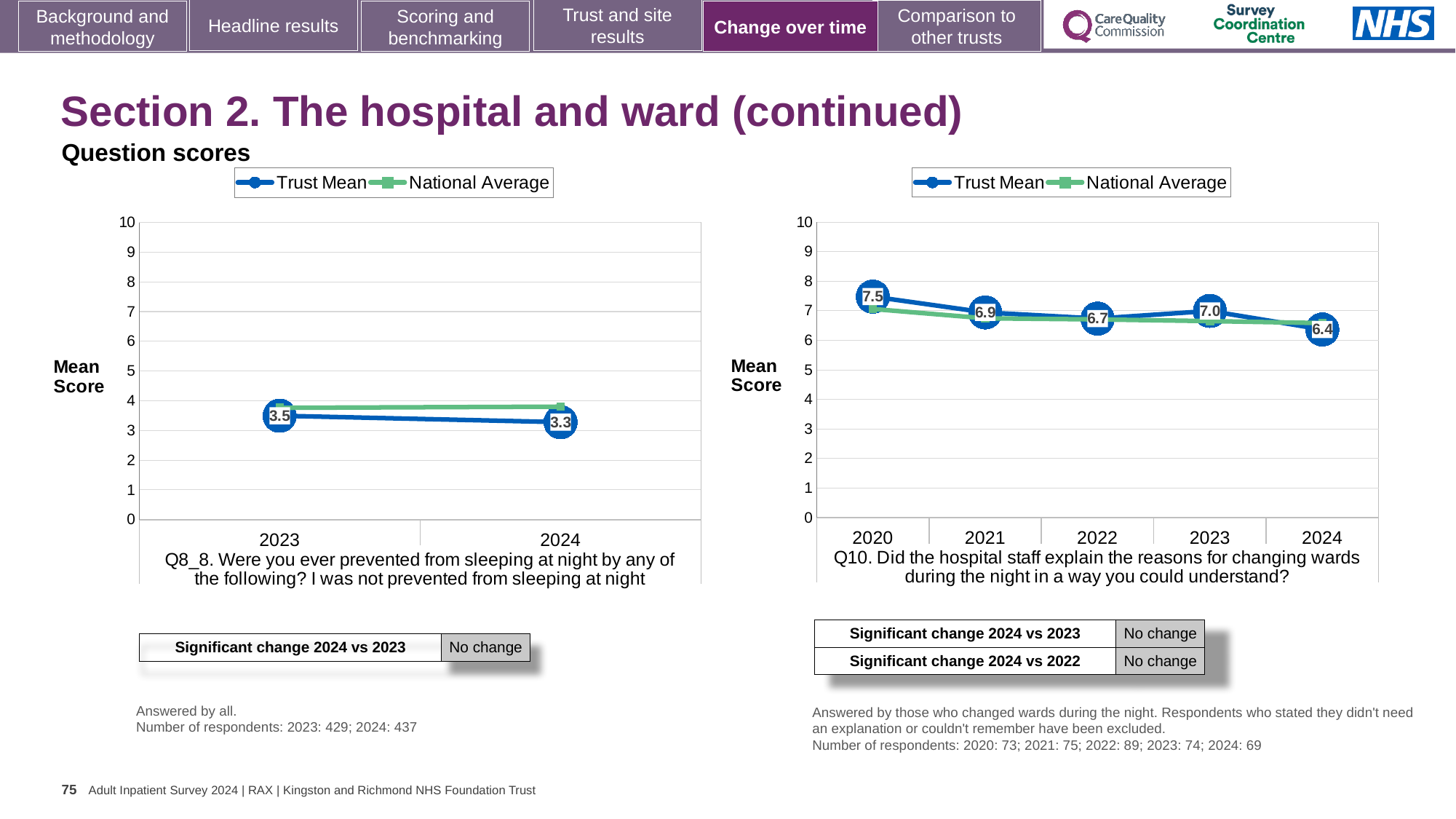
How many series does the legend of the Q8_8 chart on the left list? 2 How many years are plotted on the x axis of the Q10 chart on the right? 5 In the Q8_8 chart on the left, what is the Trust Mean score for 2024? 3.3 In the Q10 chart on the right, is the Trust Mean score higher in 2023 or in 2022? 2023 In the Q8_8 chart on the left, what is the Trust Mean score for 2023? 3.5 In the Q8_8 chart on the left, is the National Average value for 2024 greater or less than 3? greater In the Q10 chart on the right, which year has the highest Trust Mean score? 2020 In the Q10 chart on the right, what is the Trust Mean score for 2020? 7.5 What kind of chart is the Q10 chart on the right? Line chart In the Q10 chart on the right, what is the Trust Mean score for 2024? 6.4 In the Q10 chart on the right, which year has the lowest Trust Mean score? 2024 In the Q10 chart on the right, what is the difference between the Trust Mean scores for 2020 and 2024? 1.1